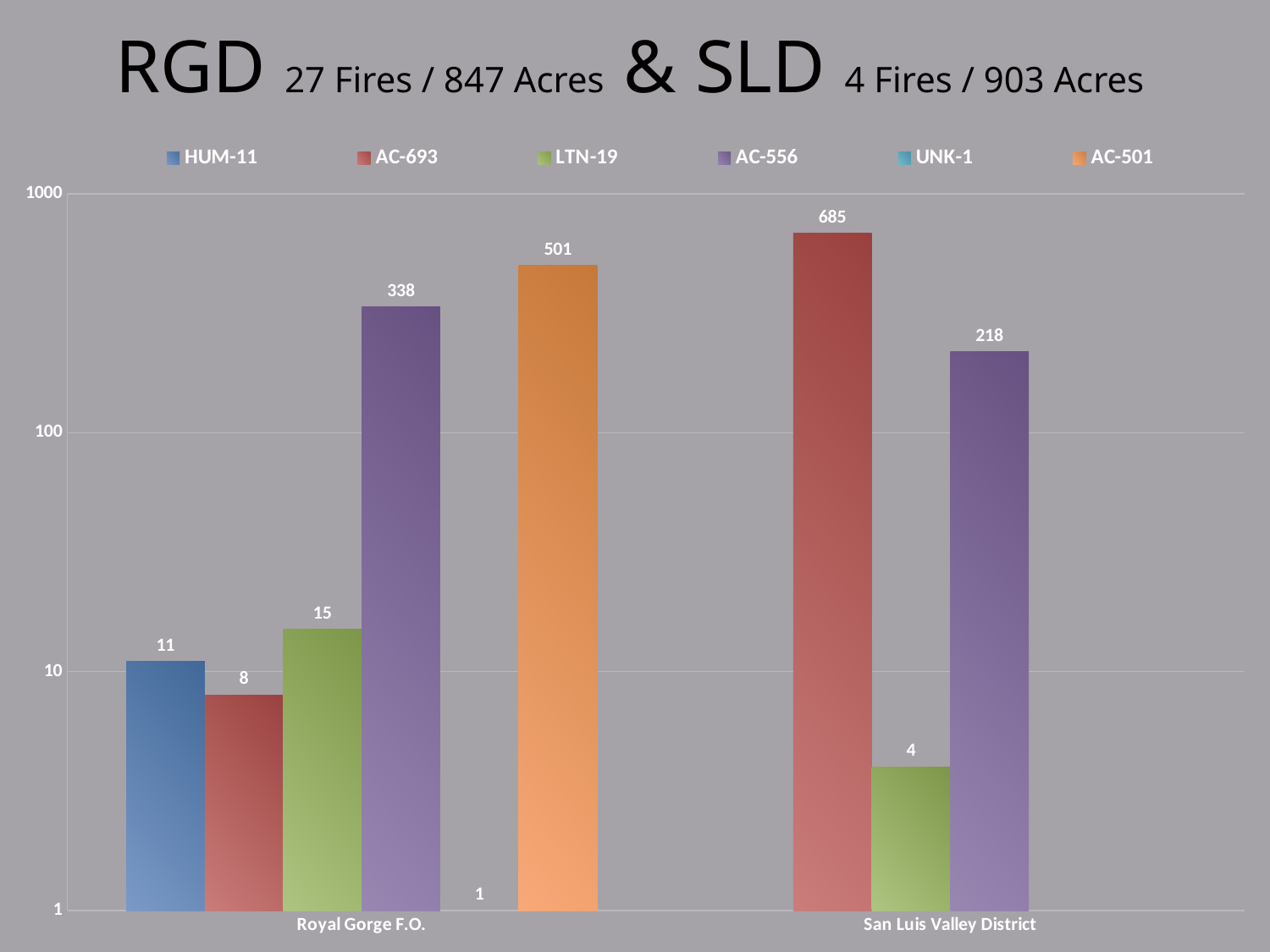
What is the value for AC-693 in San Luis Valley District? 685 Which legend entry is shown in orange? AC-501 How many series does the legend list? 6 What is the difference between the AC-556 values for San Luis Valley District and Royal Gorge F.O.? 120 How many categories are shown on the x axis? 2 What is the value for AC-501 in Royal Gorge F.O.? 501 Which series has the highest value in Royal Gorge F.O.? AC-501 Which is larger, the HUM-11 value or the LTN-19 value in Royal Gorge F.O.? LTN-19 Which series has the lowest value in Royal Gorge F.O.? UNK-1 What is the value for LTN-19 in San Luis Valley District? 4 What kind of chart is shown on the slide? bar chart What is the value for AC-556 in Royal Gorge F.O.? 338